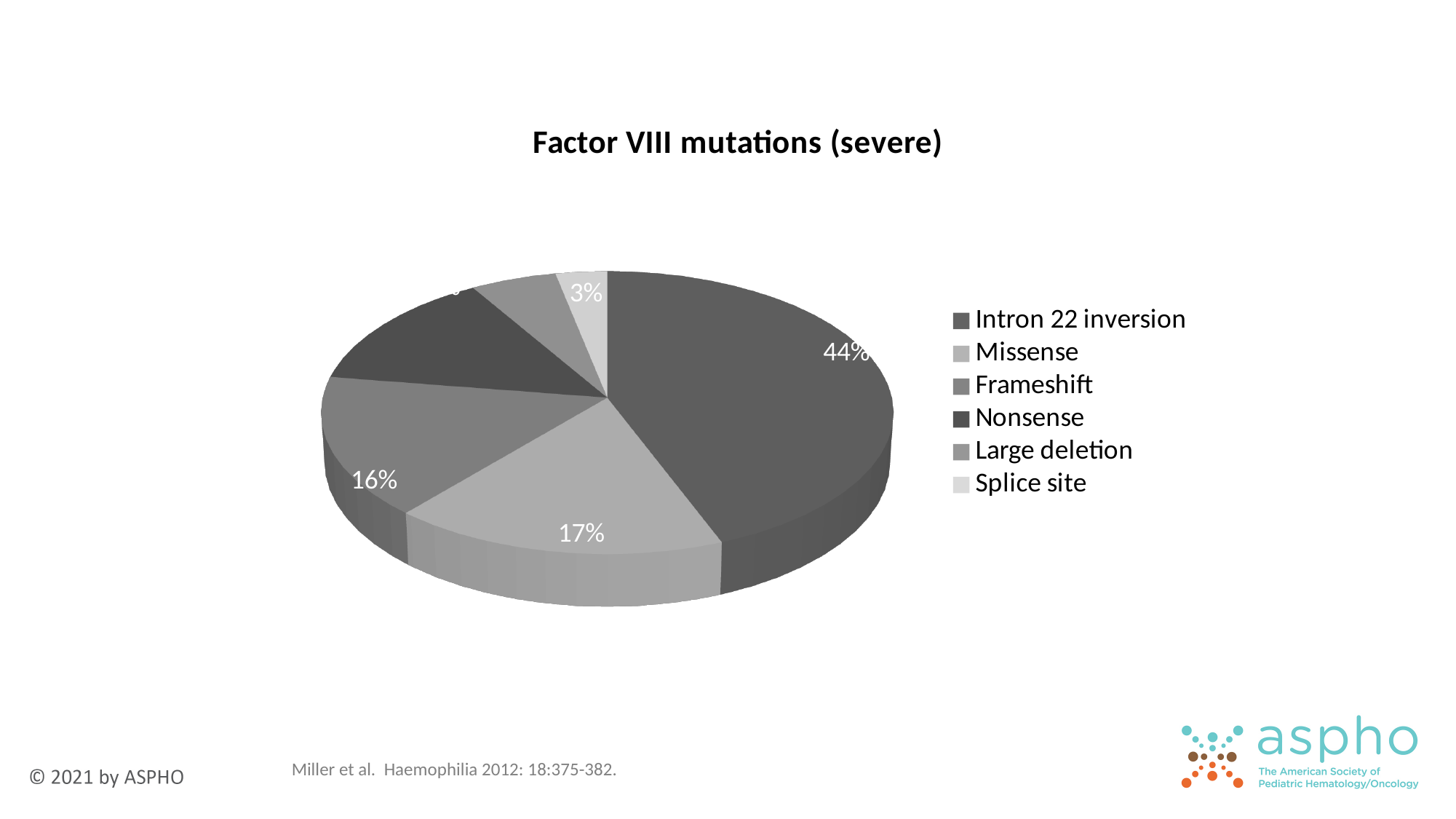
Is the share for Intron 22 inversion greater or less than 50%? less Which mutation type has the smallest share of the pie? Splice site What share of the pie is Missense? 17% What percentage of severe Factor VIII mutations are Intron 22 inversions? 44% What percentage is shown for Splice site mutations? 3% What percentage is shown for Frameshift mutations? 16% Which mutation type has the largest share of the pie? Intron 22 inversion What type of chart is shown on the slide? Pie chart How many mutation categories does the legend list? 6 Which is larger, the share for Intron 22 inversion or the share for Frameshift? Intron 22 inversion What is the title of the chart? Factor VIII mutations (severe) How many percentage points larger is the Intron 22 inversion share than the Missense share? 27 percentage points